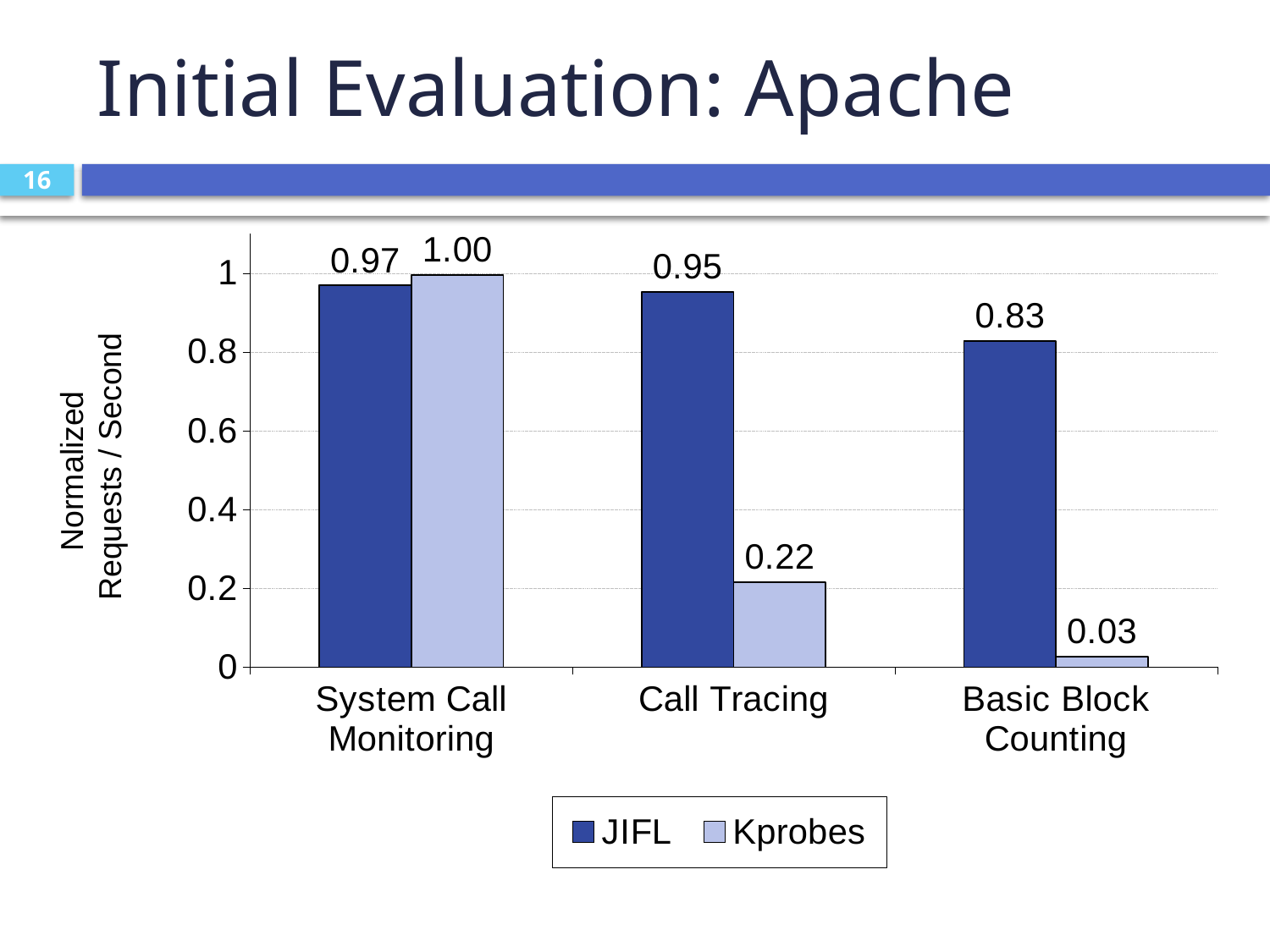
For Basic Block Counting, which series has the larger value, JIFL or Kprobes? JIFL Which category has the highest JIFL value? System Call Monitoring What is the Kprobes value for Basic Block Counting? 0.03 What is the JIFL value for System Call Monitoring? 0.97 How many categories are shown on the x axis? 3 What is the Kprobes value for Call Tracing? 0.22 What is the difference between the JIFL and Kprobes values for Call Tracing? 0.73 Which category has the lowest Kprobes value? Basic Block Counting What kind of chart is shown on the slide? Bar chart What is the label of the y axis? Normalized Requests / Second How many series does the legend list? 2 What is the JIFL value for Basic Block Counting? 0.83